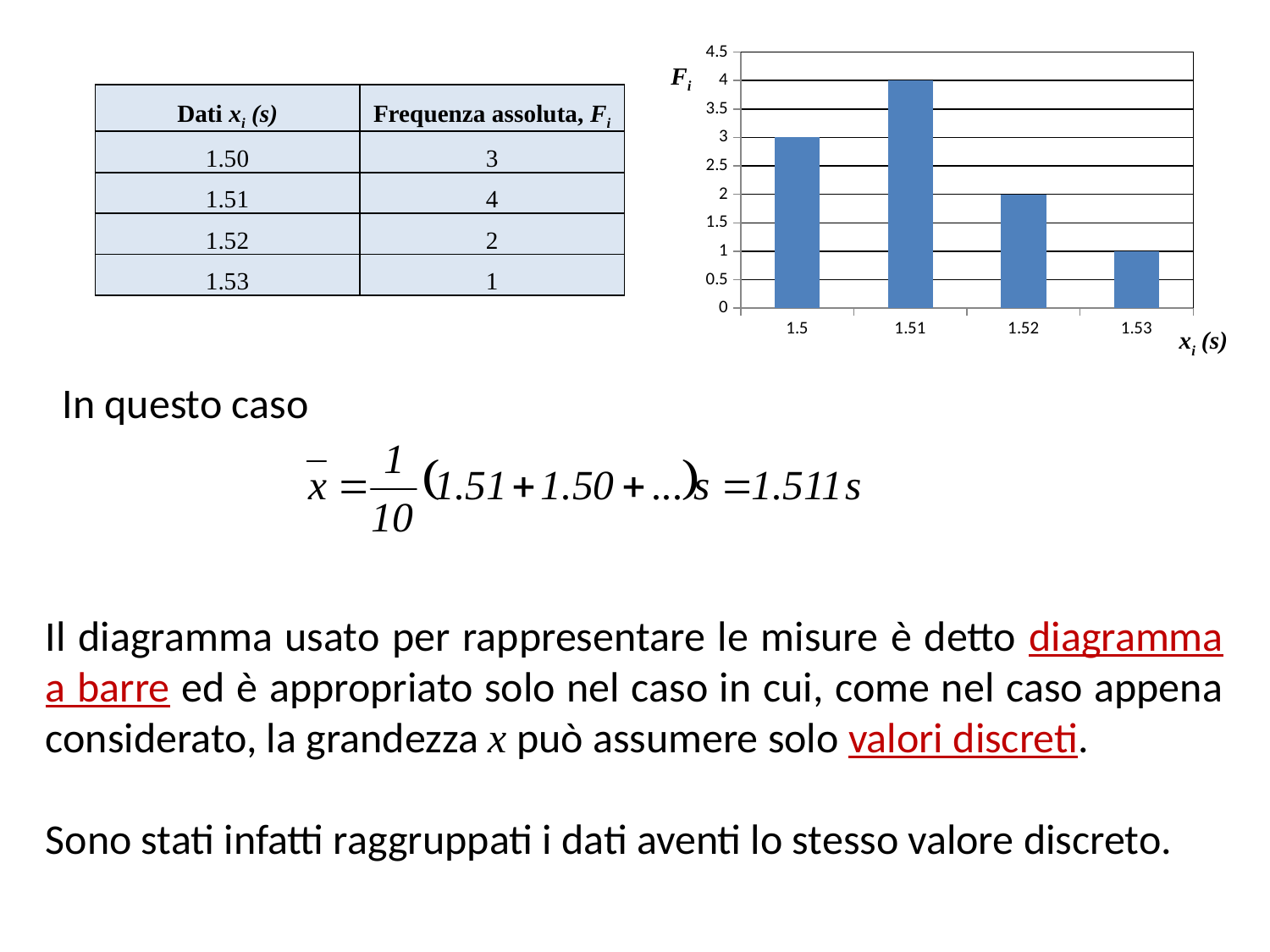
What is the label on the x axis of the chart? xi (s) What is the difference between the values for 1.51 and 1.52? 2 Which category has the highest bar? 1.51 What kind of chart is shown on the slide? bar chart How many bars does the chart have? 4 Which category has the lowest bar? 1.53 Is the value for 1.51 greater or less than 3.5? greater What is the value of the bar for 1.53? 1 What is the value of the bar for 1.5? 3 Which is larger, the value for 1.5 or the value for 1.52? 1.5 Do the bar values rise or fall from 1.51 to 1.53 along the x axis? fall What is the value of the bar for 1.51? 4